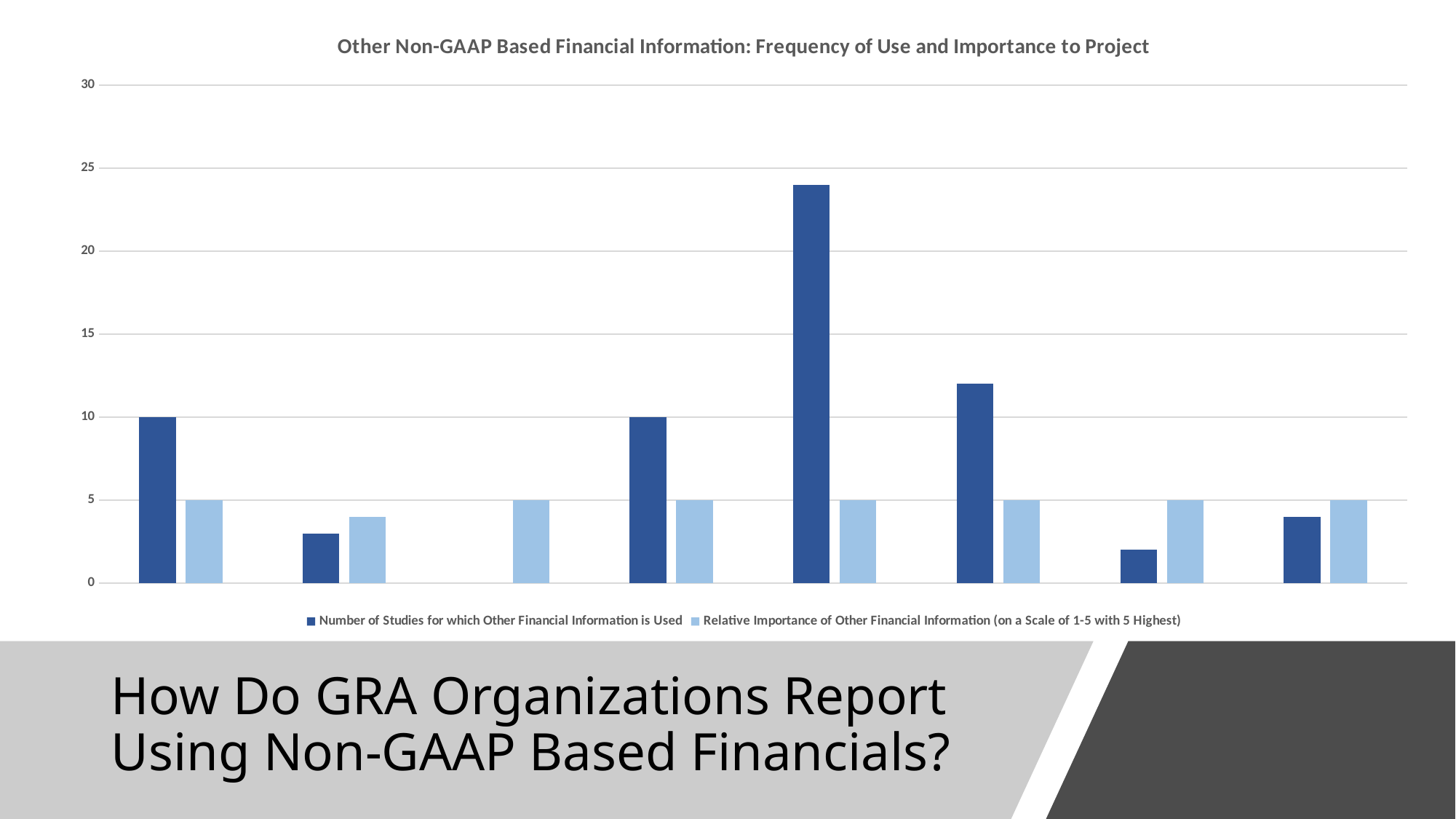
Which group of bars, counting from the left, has the tallest bar for Number of Studies for which Other Financial Information is Used? the fifth group What is the value of the Relative Importance of Other Financial Information bar in the first group from the left? 5 How many series does the legend list? 2 Is the tallest bar for Number of Studies for which Other Financial Information is Used greater or less than 20? greater What is the value of the Number of Studies for which Other Financial Information is Used bar in the first group from the left? 10 What is the title of the chart? Other Non-GAAP Based Financial Information: Frequency of Use and Importance to Project In the second group from the left, which bar is taller: Number of Studies for which Other Financial Information is Used or Relative Importance of Other Financial Information? Relative Importance of Other Financial Information Which series is shown in the darker blue colour? Number of Studies for which Other Financial Information is Used How many groups of bars are plotted along the x axis? 8 Is the Number of Studies for which Other Financial Information is Used bar in the sixth group from the left greater or less than 10? greater What kind of chart is shown on the slide? bar chart Is the Number of Studies for which Other Financial Information is Used bar in the seventh group from the left greater or less than 5? less